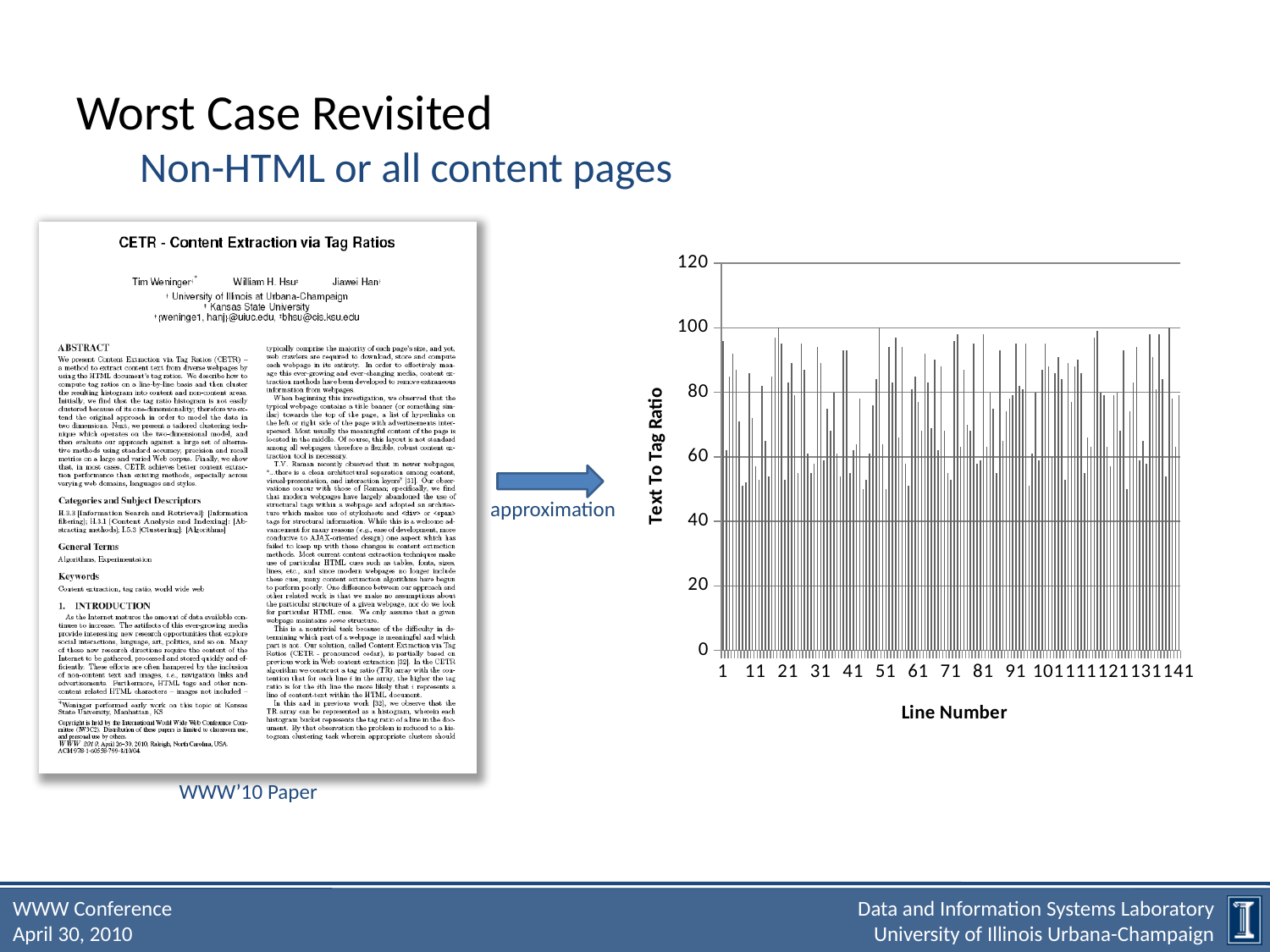
Is the lowest Text To Tag Ratio value in the chart greater or less than 20? greater How many tick labels are shown on the x axis of the chart? 15 What is the title of the y axis of the chart? Text To Tag Ratio What kind of chart is shown on the right side of the slide? bar chart What is the title of the x axis of the chart? Line Number How many data series are plotted in the chart? 1 Is the highest Text To Tag Ratio value in the chart greater or less than 120? less